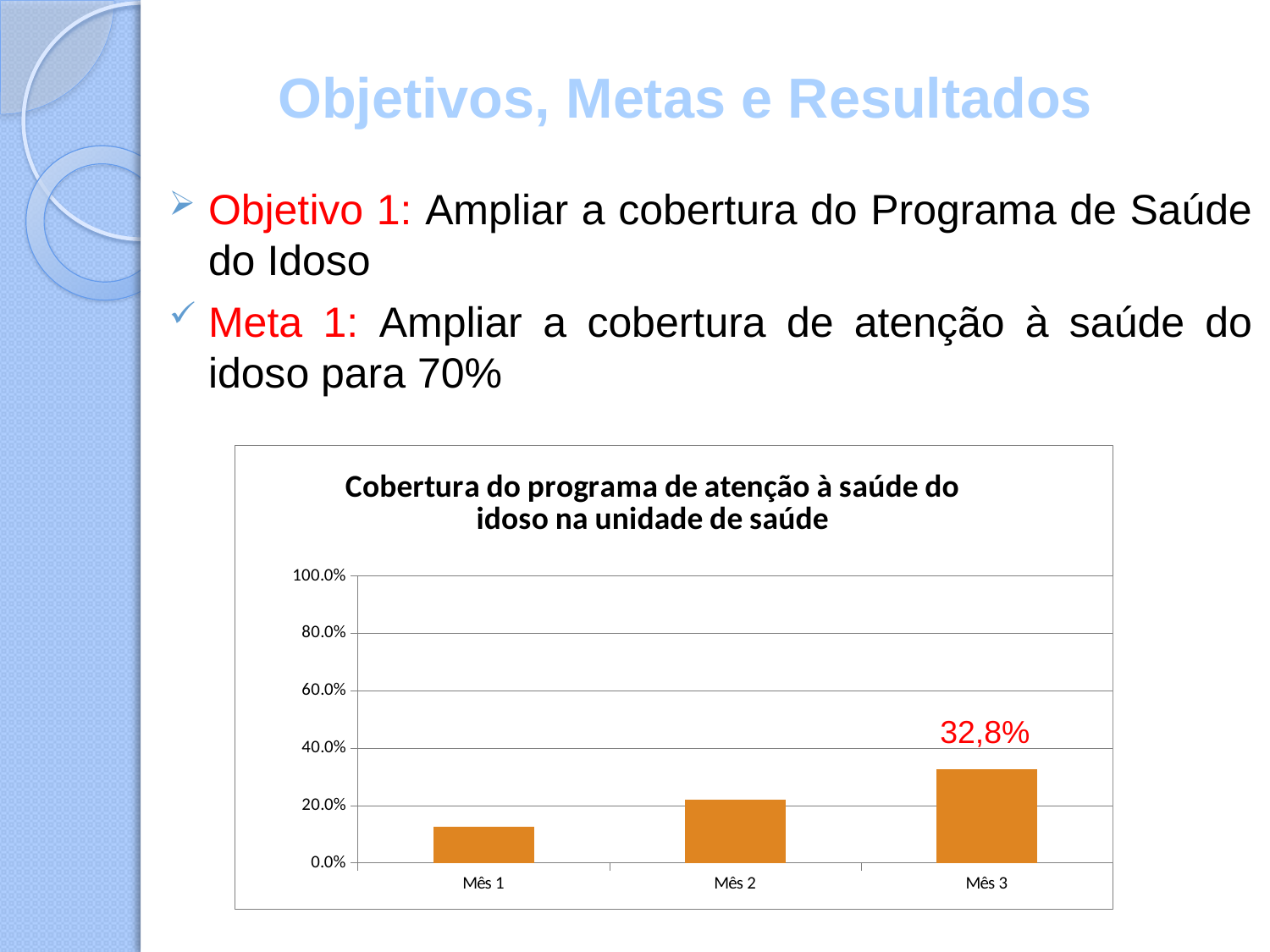
What is the title of the chart? Cobertura do programa de atenção à saúde do idoso na unidade de saúde How many months are shown on the x axis of the chart? 3 Which is larger, the value for Mês 1 or the value for Mês 2? Mês 2 Do the values rise or fall from Mês 1 to Mês 3? rise Is the value for Mês 2 greater or less than 20.0%? greater Is the value for Mês 1 greater or less than 20.0%? less Which month has the highest coverage in the chart? Mês 3 Is the value for Mês 3 greater or less than 40.0%? less Which month has the lowest coverage in the chart? Mês 1 What colour are the bars in the chart? orange What is the value shown for Mês 3 in the chart? 32,8% What kind of chart is shown on the slide? bar chart